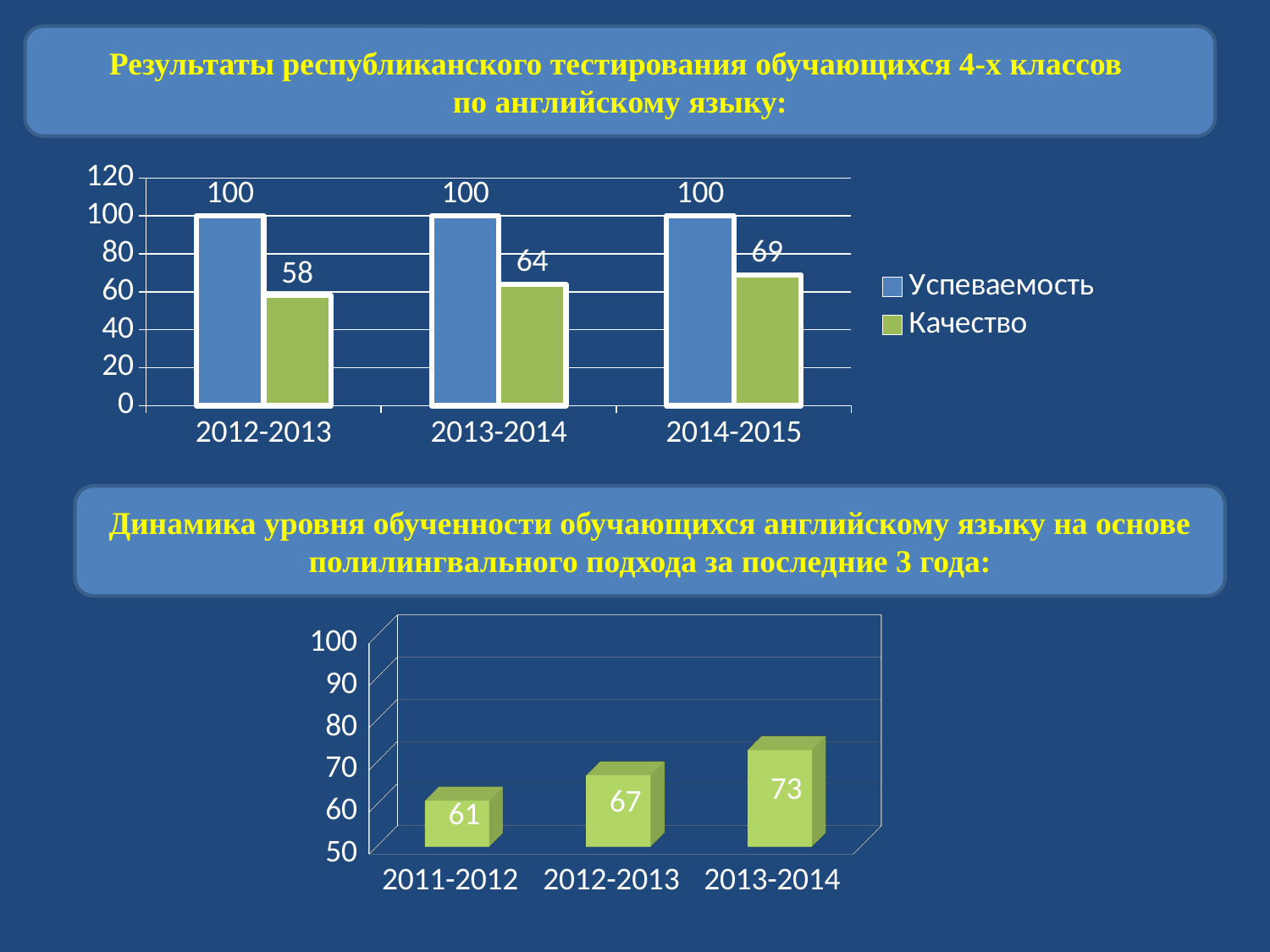
What kind of chart is the bottom chart? bar chart In the top chart, what is the difference between Успеваемость and Качество for 2013-2014? 36 In the top chart, what is the value of Успеваемость for 2014-2015? 100 In the bottom chart, what is the difference between the values for 2013-2014 and 2011-2012? 12 In the top chart, does the Качество value rise or fall from 2012-2013 to 2014-2015? rise In the top chart, what is the value of Качество for 2012-2013? 58 In the top chart, which colour represents Качество? green In the top chart, which year has the lowest Качество value? 2012-2013 In the bottom chart, how many categories are shown on the x axis? 3 In the top chart, how many series does the legend list? 2 In the bottom chart, what is the value for 2012-2013? 67 In the top chart, which year has the highest Качество value? 2014-2015